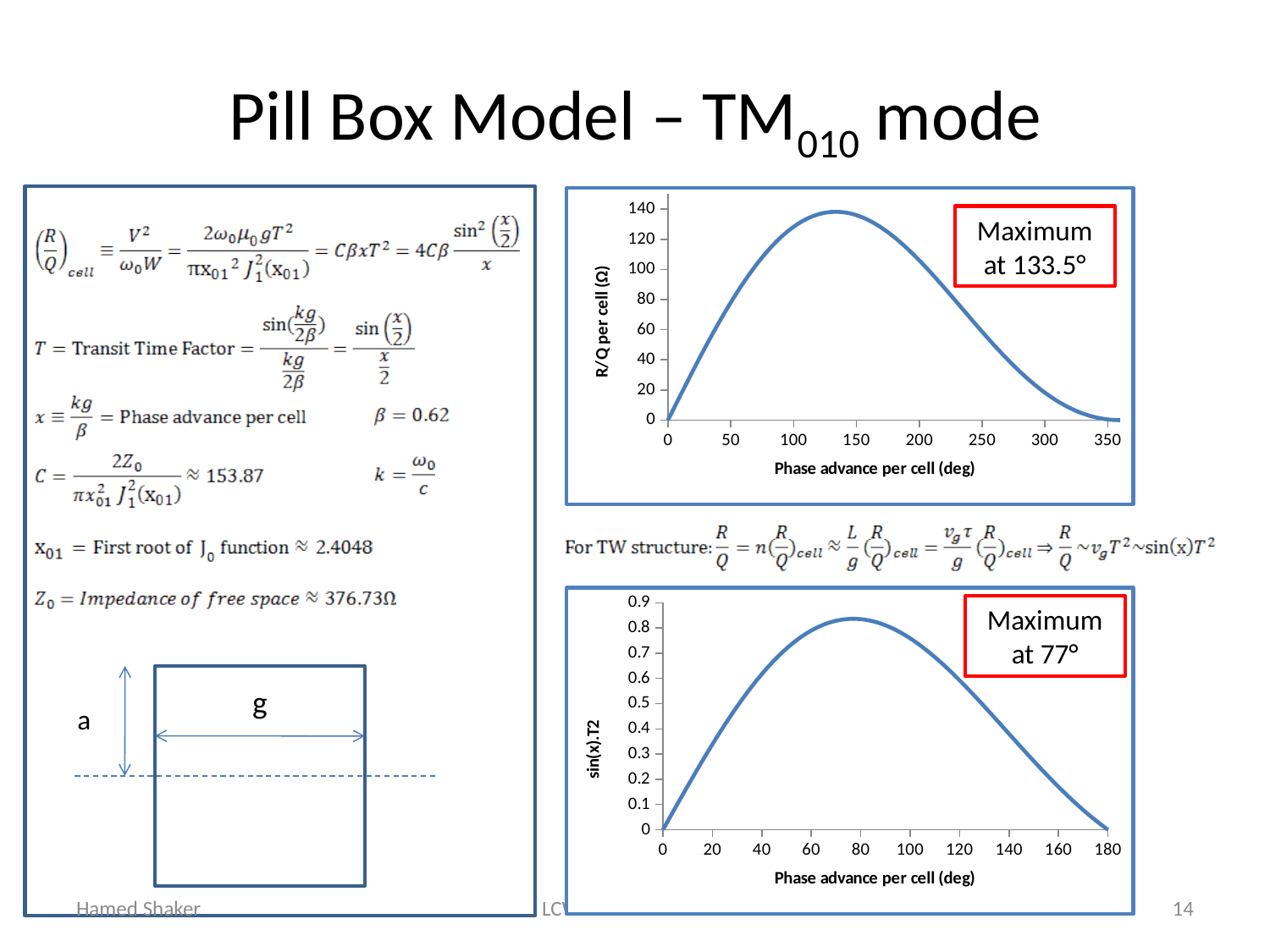
In the top chart (R/Q per cell), is the value at a phase advance of 300 degrees greater or less than 40? less In the top chart (R/Q per cell), which has the larger value: a phase advance of 150 degrees or 250 degrees? 150 degrees In the bottom chart (sin(x).T2), is the value at a phase advance of 160 degrees greater or less than 0.4? less In the top chart (R/Q per cell), does the curve rise or fall as the phase advance goes from 200 to 350 degrees? fall In the top chart (R/Q per cell), is the value at a phase advance of 100 degrees greater or less than 100? greater In the bottom chart (sin(x).T2), does the curve rise or fall as the phase advance goes from 0 to 60 degrees? rise What kind of chart is the top chart on the right side of the slide? line chart In the top chart (R/Q per cell), at what phase advance does the annotation say the maximum occurs? 133.5° What kind of chart is the bottom chart on the right side of the slide? line chart In the bottom chart (sin(x).T2), at what phase advance does the annotation say the maximum occurs? 77°